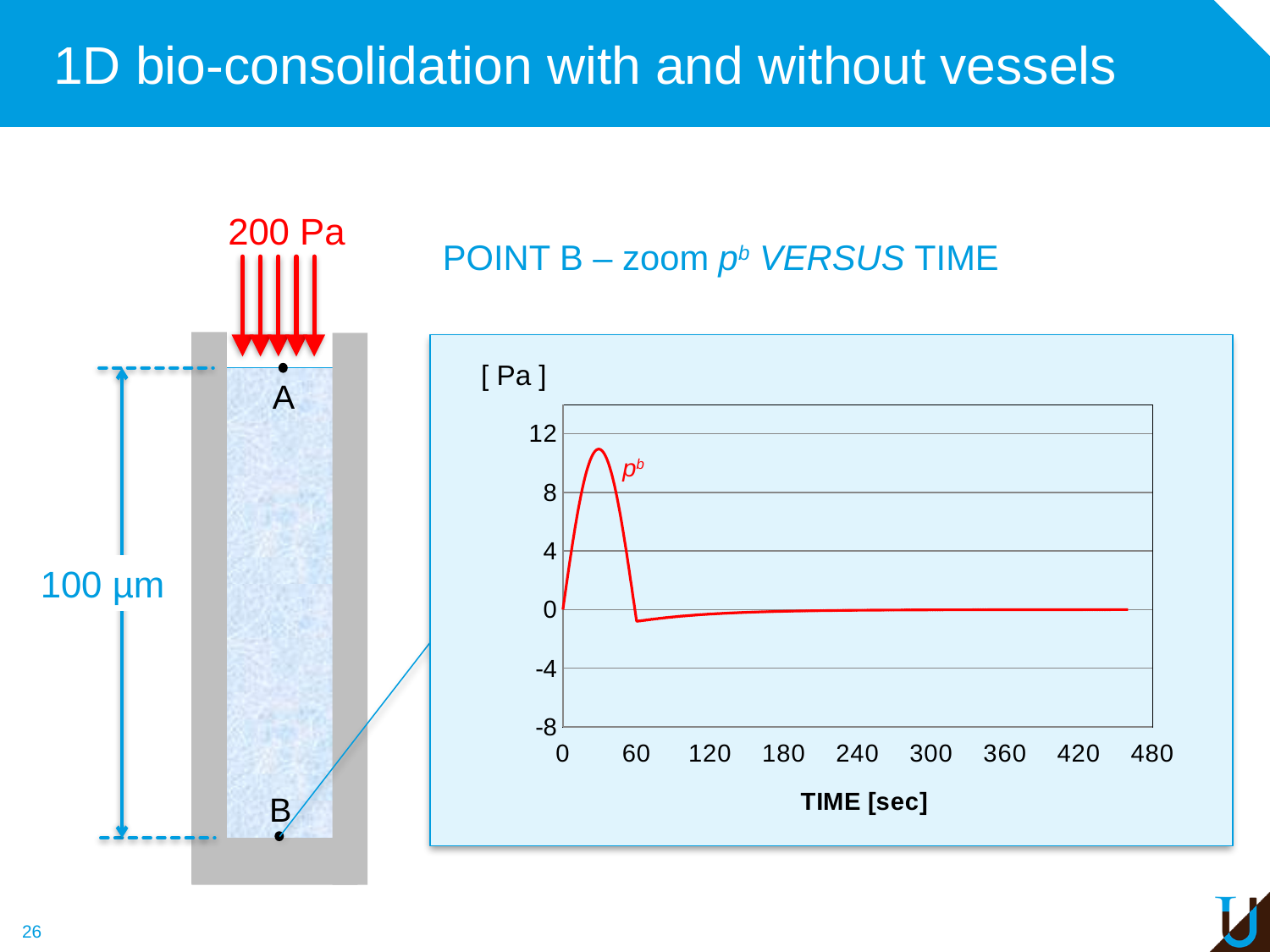
Is the value of p^b at 300 sec greater or less than -4? greater Does the value of p^b rise or fall between 30 sec and 60 sec? fall What is the x-axis title of the chart? TIME [sec] What is the largest tick value shown on the x axis of the chart? 480 Is the peak value of p^b greater or less than 8? greater Is the value of p^b at 240 sec greater or less than 4? less Does the value of p^b rise or fall between 0 sec and 30 sec? rise What is the label of the series plotted in the chart? p^b How many series are plotted in the chart? 1 What kind of chart is shown on the slide? line chart